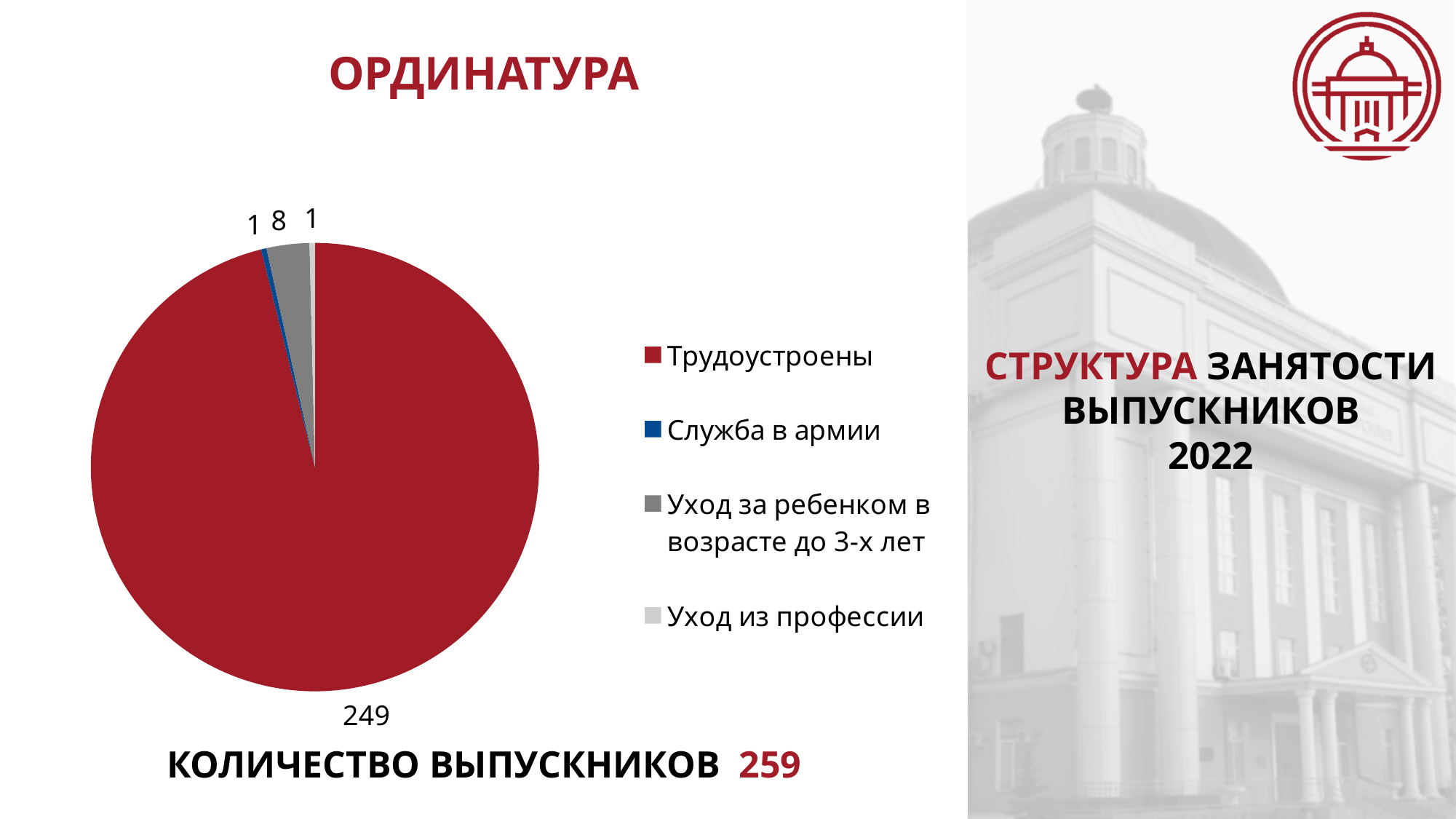
What is the value for Уход за ребенком в возрасте до 3-х лет? 8 Which category has the largest slice of the pie? Трудоустроены What colour is the slice for Служба в армии? blue How many slices does the pie chart have? 4 What kind of chart is shown on the slide? pie chart Which is larger, the value for Уход за ребенком в возрасте до 3-х лет or the value for Служба в армии? Уход за ребенком в возрасте до 3-х лет What is the value for Трудоустроены? 249 What is the title above the pie chart? ОРДИНАТУРА What is the difference between the values for Трудоустроены and Уход за ребенком в возрасте до 3-х лет? 241 What is the value for Служба в армии? 1 What is the value for Уход из профессии? 1 What is the total number of graduates (количество выпускников) stated on the slide? 259